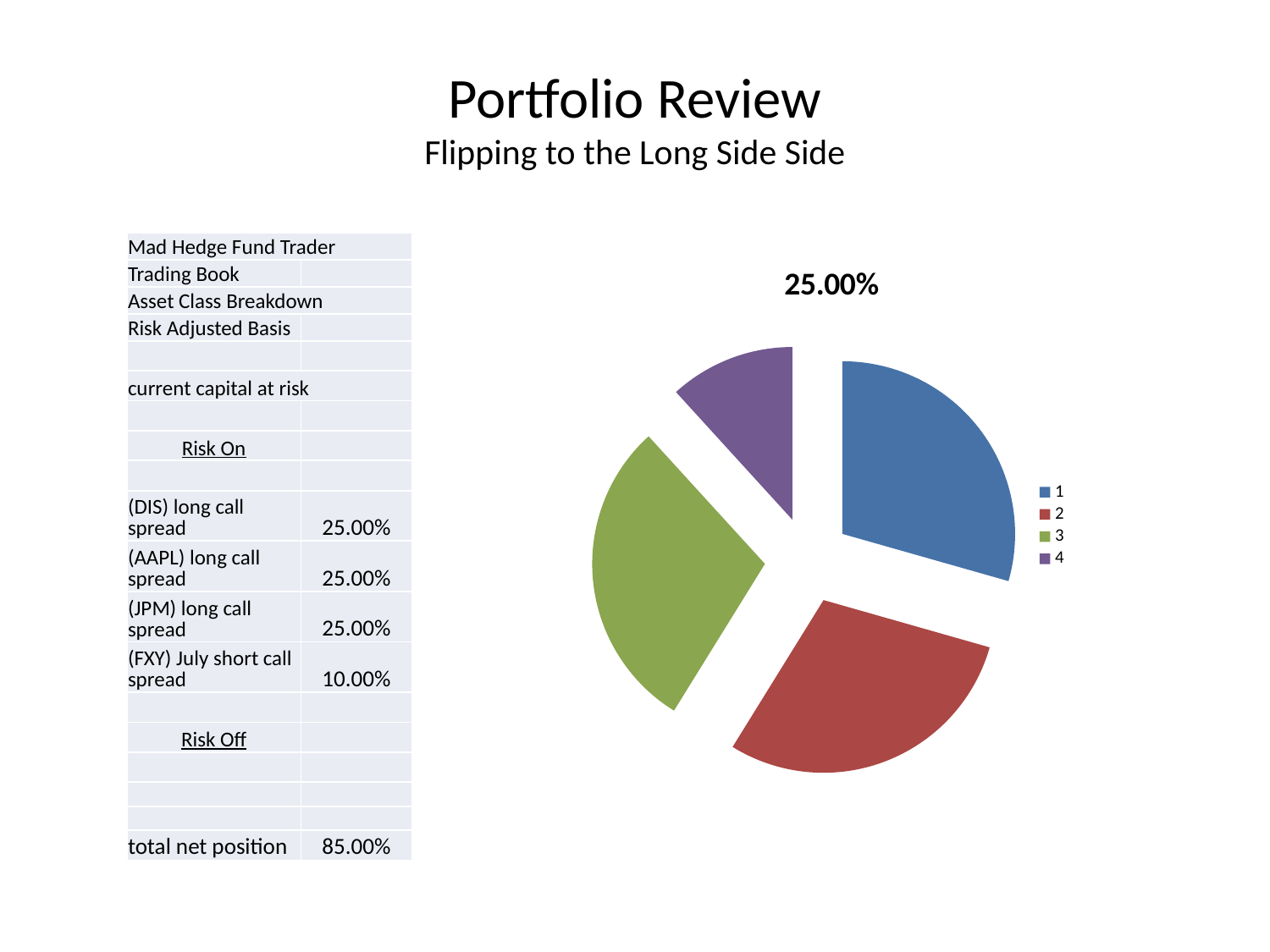
What kind of chart is shown on the slide? pie chart Which legend category has the smallest slice in the pie chart? 4 Which slice is larger in the pie chart, category 1 or category 4? 1 How many slices does the pie chart have? 4 How many entries does the pie chart's legend list? 4 Which slice is larger in the pie chart, category 4 or category 2? 2 What is the title shown above the pie chart? 25.00% Which slice is larger in the pie chart, category 3 or category 4? 3 What colour is the slice for category 4 in the pie chart? purple